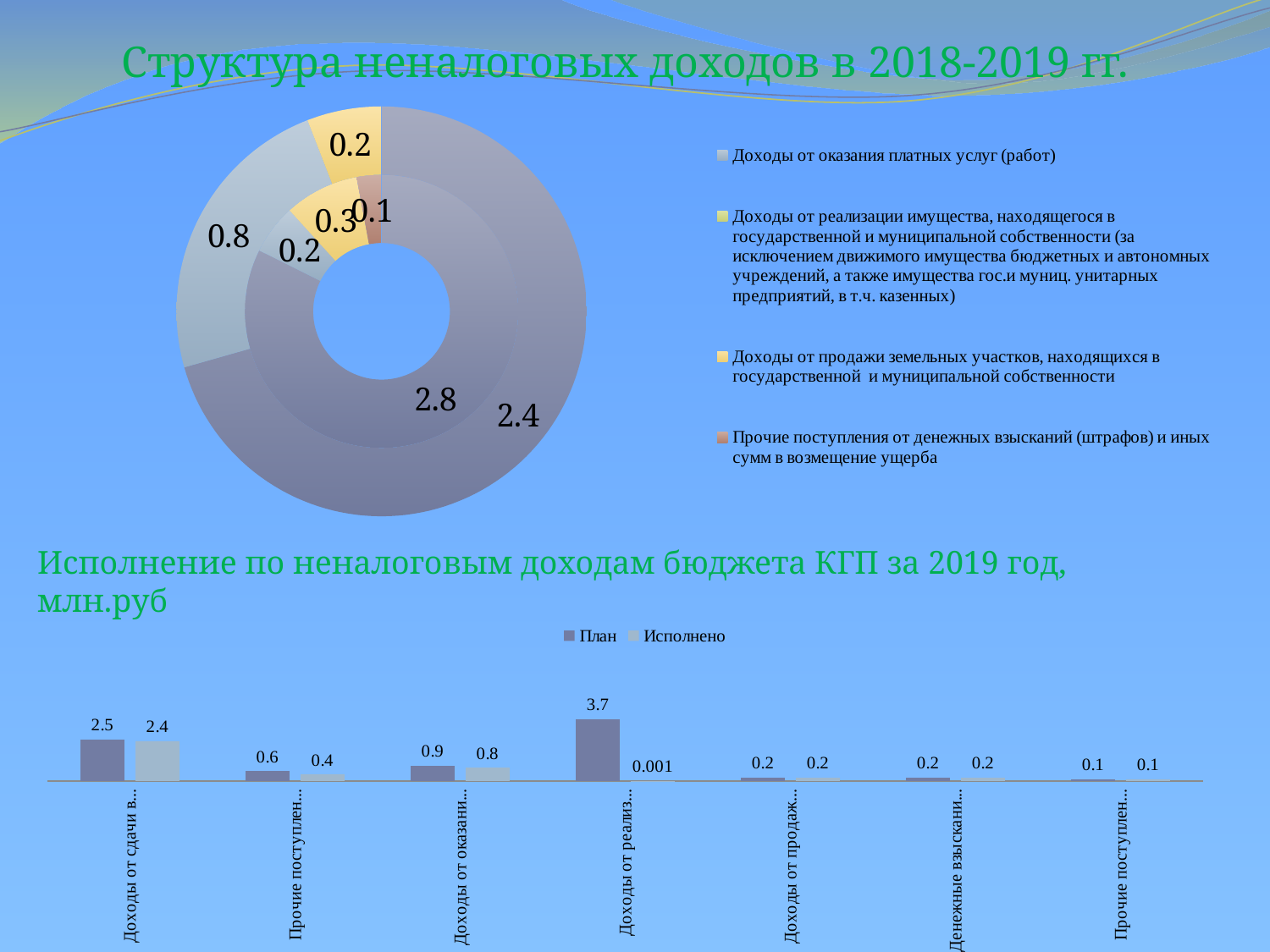
How many entries does the legend of the top doughnut chart list? 4 What kind of chart is the top chart titled 'Структура неналоговых доходов в 2018-2019 гг.'? doughnut chart How many series does the legend of the bottom bar chart list? 2 What is the largest value labeled on the top doughnut chart? 2.8 In the bottom bar chart, which category has the highest План value? Доходы от реализ... How many categories are shown on the x axis of the bottom bar chart? 7 In the bottom bar chart, what is the Исполнено value for the category 'Доходы от реализ...'? 0.001 What kind of chart is the bottom chart titled 'Исполнение по неналоговым доходам бюджета КГП за 2019 год, млн.руб'? bar chart In the bottom bar chart, what is the План value for the category 'Доходы от реализ...'? 3.7 In the bottom bar chart, what is the difference between План and Исполнено for the first category 'Доходы от сдачи в...'? 0.1 In the bottom bar chart, what is the Исполнено value for the first category 'Доходы от сдачи в...'? 2.4 In the bottom bar chart, which is larger for 'Доходы от оказани...': План or Исполнено? План